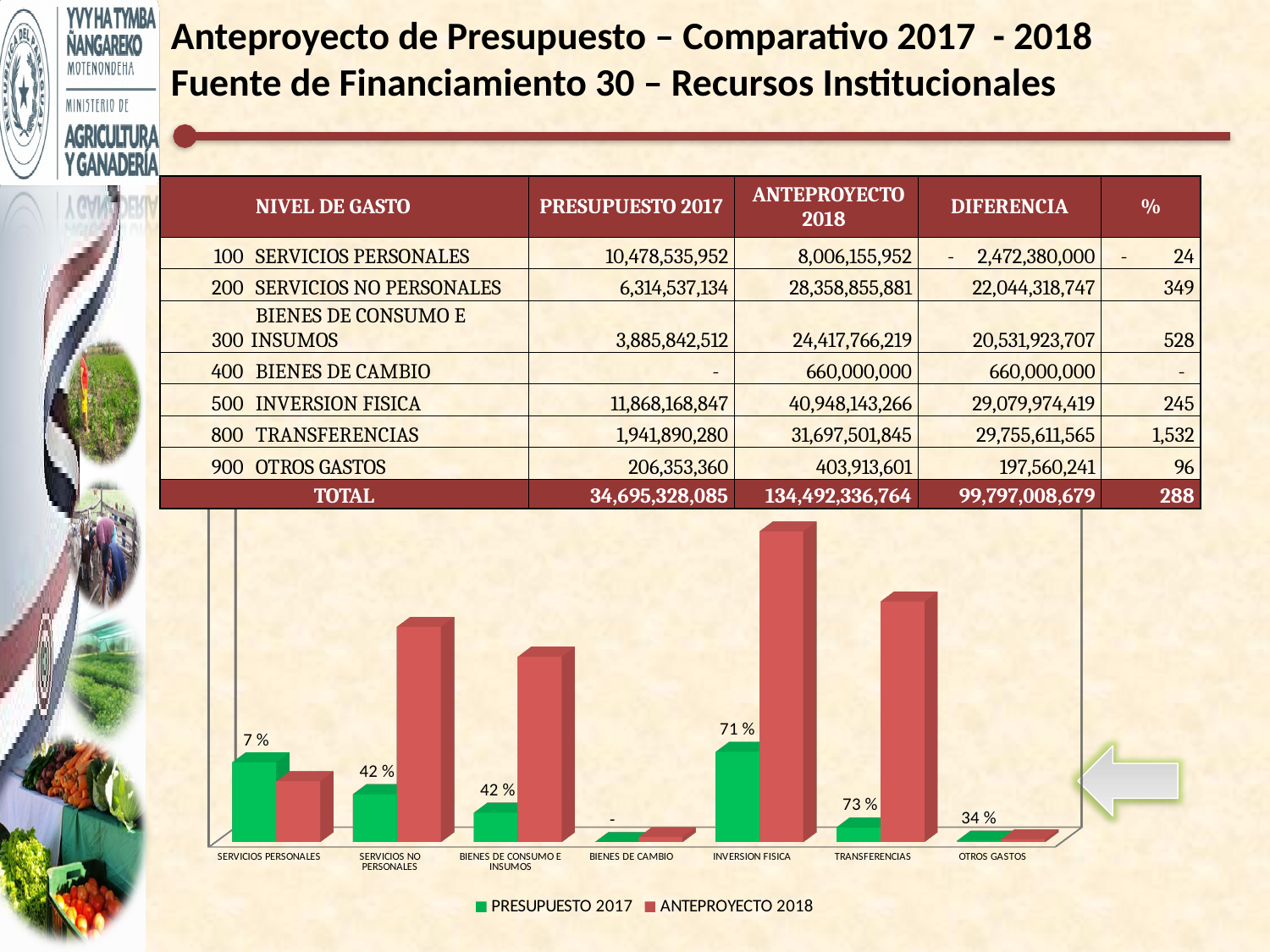
For INVERSION FISICA, which series has the taller bar, PRESUPUESTO 2017 or ANTEPROYECTO 2018? ANTEPROYECTO 2018 For SERVICIOS PERSONALES, which series has the taller bar, PRESUPUESTO 2017 or ANTEPROYECTO 2018? PRESUPUESTO 2017 Which category has no PRESUPUESTO 2017 bar in the chart? BIENES DE CAMBIO What percentage label is printed for OTROS GASTOS in the chart? 34 % Which category has the tallest PRESUPUESTO 2017 bar in the chart? INVERSION FISICA What percentage label is printed for INVERSION FISICA in the chart? 71 % Which series is shown in green in the chart legend? PRESUPUESTO 2017 What kind of chart is shown at the bottom of the slide? bar chart What percentage label is printed for TRANSFERENCIAS in the chart? 73 % How many categories are shown along the x axis of the chart? 7 How many series does the chart legend list? 2 Which category has the tallest ANTEPROYECTO 2018 bar in the chart? INVERSION FISICA